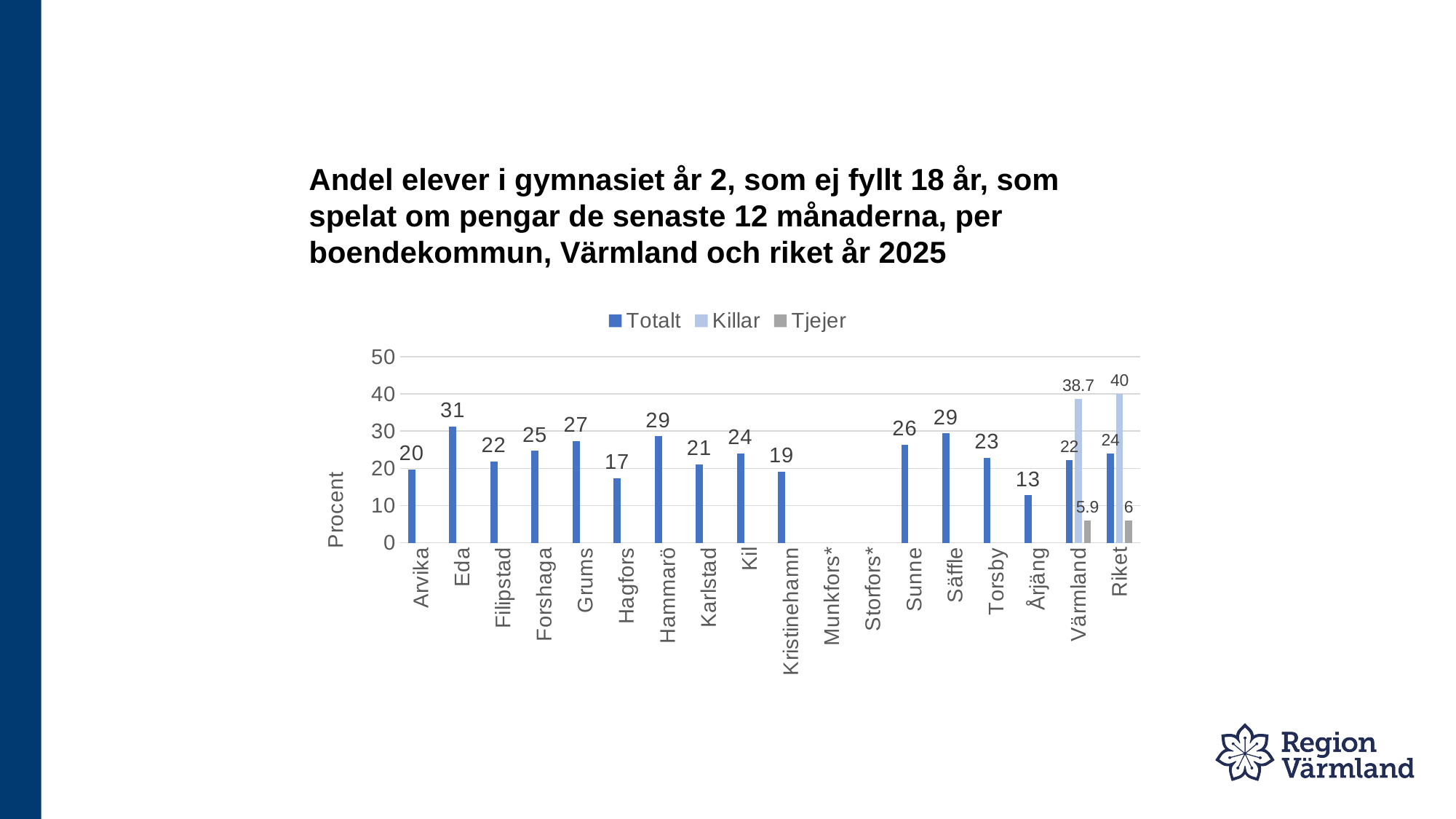
What is the difference between the Totalt values for Hammarö and Hagfors? 12 What is the label of the vertical axis? Procent What is the Totalt value for Eda? 31 Which municipality has the lowest Totalt value? Årjäng How many series does the legend list? 3 What kind of chart is shown on the slide? Bar chart What is the Tjejer value for Riket? 6 What is the Totalt value for Kristinehamn? 19 Which has a larger Totalt value, Sunne or Karlstad? Sunne Which municipality has the highest Totalt value? Eda What is the Killar value for Värmland? 38.7 What is the difference between the Killar and Tjejer values for Riket? 34